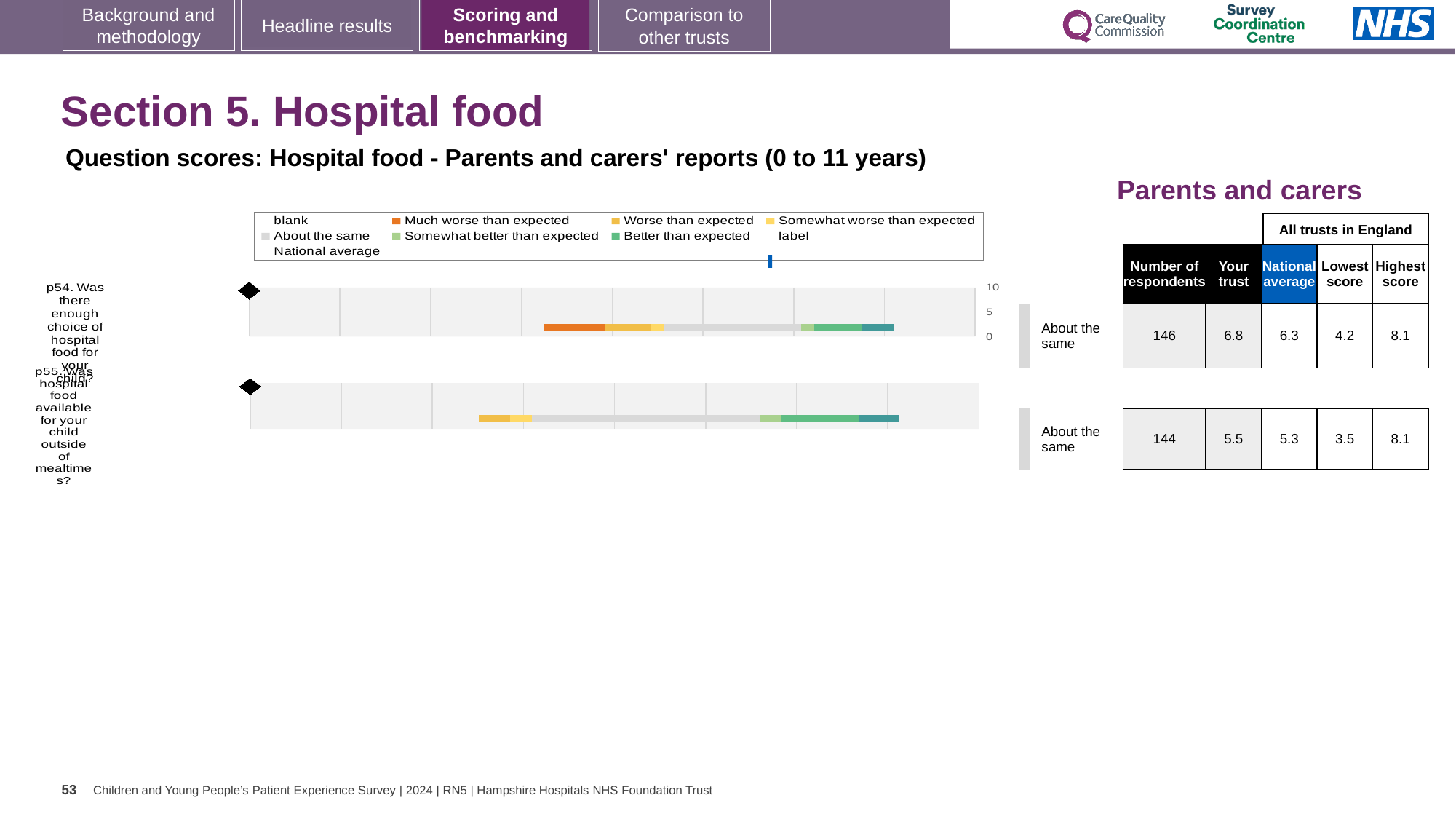
In the table beside the chart, what is the 'Your trust' score for p55 (hospital food available outside of mealtimes)? 5.5 What kind of chart is shown on the slide? bar chart What is the highest value shown on the chart's axis? 10 How many questions (categories) are plotted in the chart? 2 Which question has the higher 'Your trust' score in the table, p54 or p55? p54 In the table beside the chart, what is the national average for p55? 5.3 In the table beside the chart, what is the lowest score for p55? 3.5 In the table beside the chart, what is the national average for p54? 6.3 In the table beside the chart, what is the highest score for p54? 8.1 What is the difference between the 'Your trust' score and the national average for p54 in the table? 0.5 Which legend entry is shown in orange? Much worse than expected In the table beside the chart, what is the 'Your trust' score for p54 (enough choice of hospital food)? 6.8